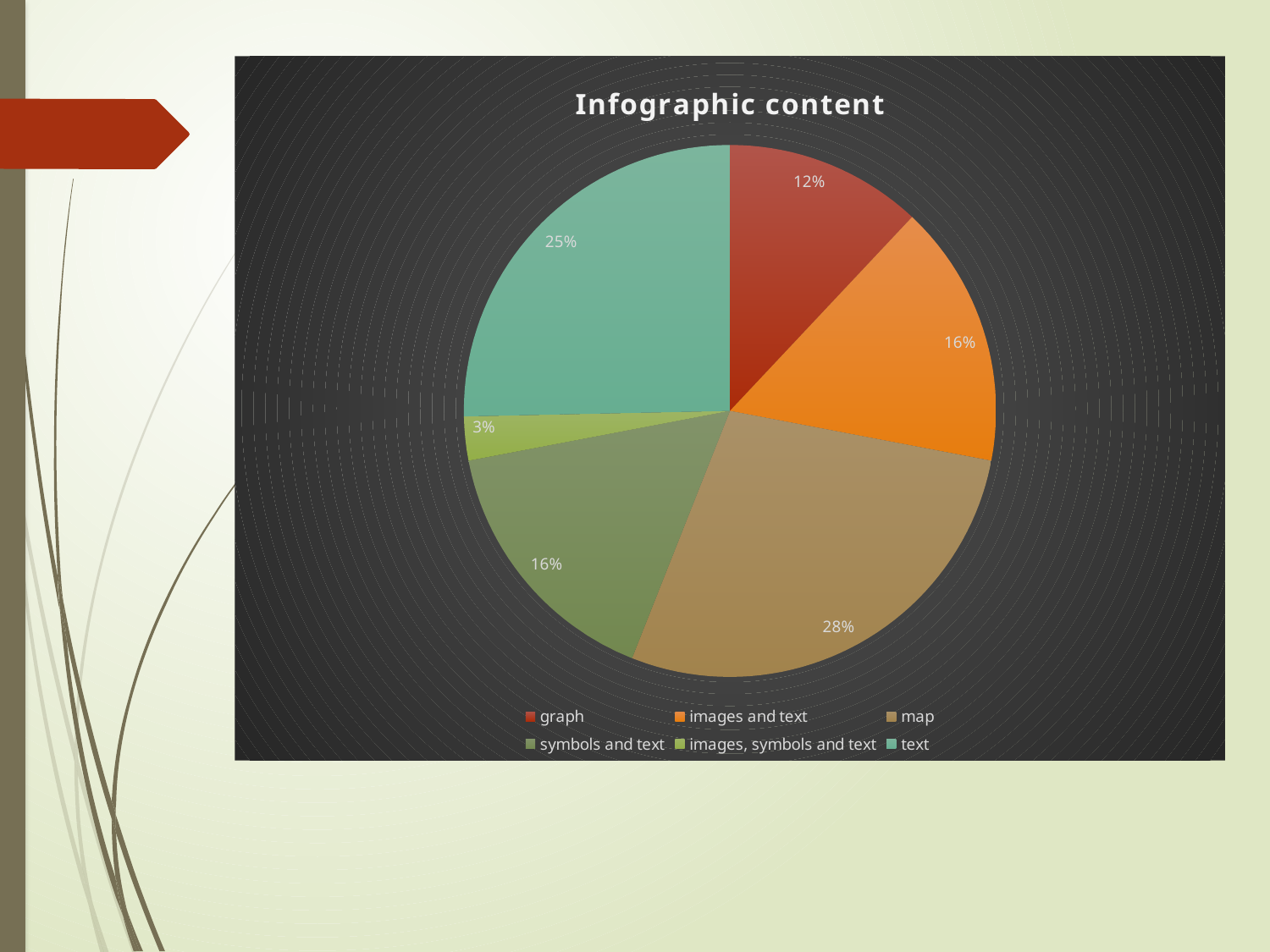
What is the difference in percentage points between the 'map' slice and the 'text' slice? 3 Which is larger, the 'text' slice or the 'graph' slice? text What share of the pie does the 'graph' slice represent? 12% What share of the pie does the 'text' slice represent? 25% Which category has the smallest slice of the pie? images, symbols and text What share of the pie does the 'map' slice represent? 28% What is the difference in percentage points between the 'images and text' slice and the 'images, symbols and text' slice? 13 What is the title of the chart? Infographic content What type of chart is shown on the slide? pie chart Which category has the largest slice of the pie? map How many categories does the pie chart show? 6